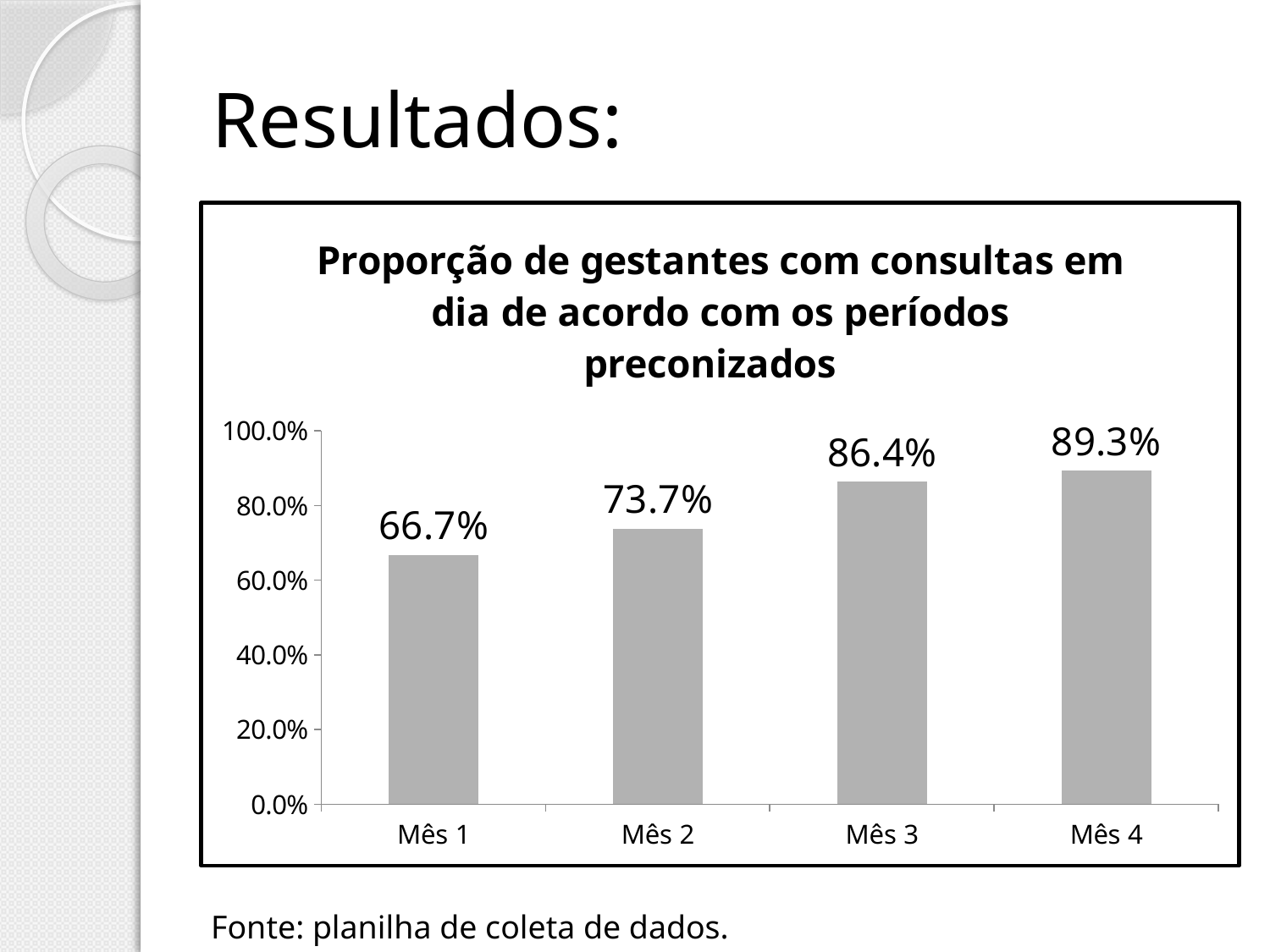
What is the difference between the values for Mês 3 and Mês 2? 12.7% Is the value for Mês 2 greater or less than 80.0%? less Do the values rise or fall from Mês 1 to Mês 4? rise What is the title of the chart? Proporção de gestantes com consultas em dia de acordo com os períodos preconizados Which month has the lowest proportion? Mês 1 What kind of chart is shown? bar chart Which month has the highest proportion? Mês 4 What is the value for Mês 3? 86.4% How many months are shown on the x axis? 4 What is the value for Mês 1? 66.7% What is the difference between the values for Mês 4 and Mês 1? 22.6% Which is larger, the value for Mês 2 or the value for Mês 3? Mês 3